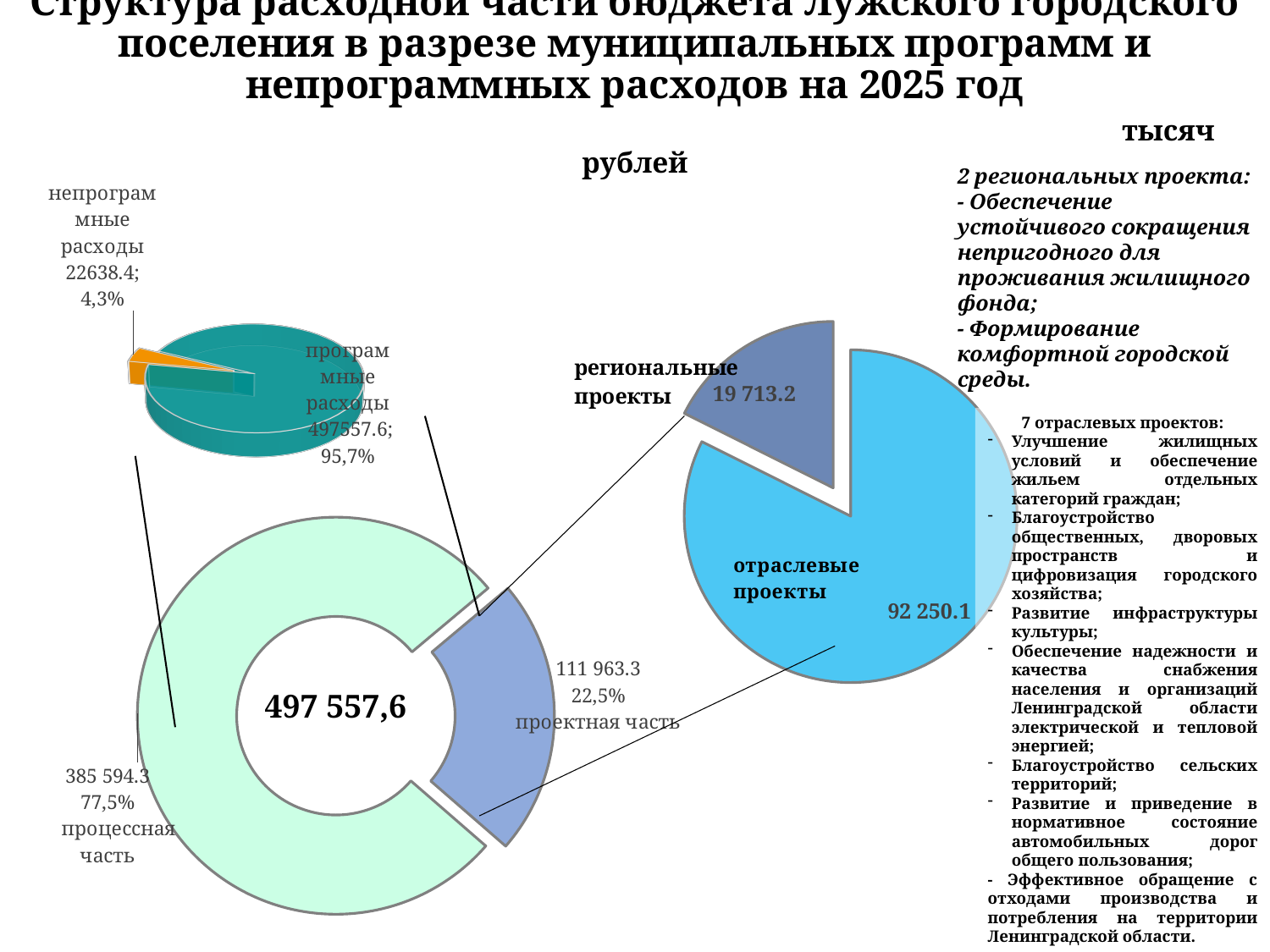
In the small 3D pie chart at the top left, how many slices are there? 2 In the small 3D pie chart at the top left, which slice is the largest? программные расходы In the small 3D pie chart at the top left, what is the value for непрограммные расходы? 22638.4 In the small 3D pie chart at the top left, what share of the pie is программные расходы? 95,7% In the pie chart on the right, which slice is the smallest? региональные проекты In the pie chart on the right, what is the value for отраслевые проекты? 92 250.1 In the donut chart in the centre of the slide, which is larger, процессная часть or проектная часть? процессная часть In the pie chart on the right, what is the value for региональные проекты? 19 713.2 In the donut chart in the centre of the slide, what number is shown in the middle of the donut? 497 557,6 In the donut chart in the centre of the slide, what share is проектная часть? 22,5% In the donut chart in the centre of the slide, what is the value for процессная часть? 385 594.3 What kind of chart is the chart on the right of the slide? pie chart